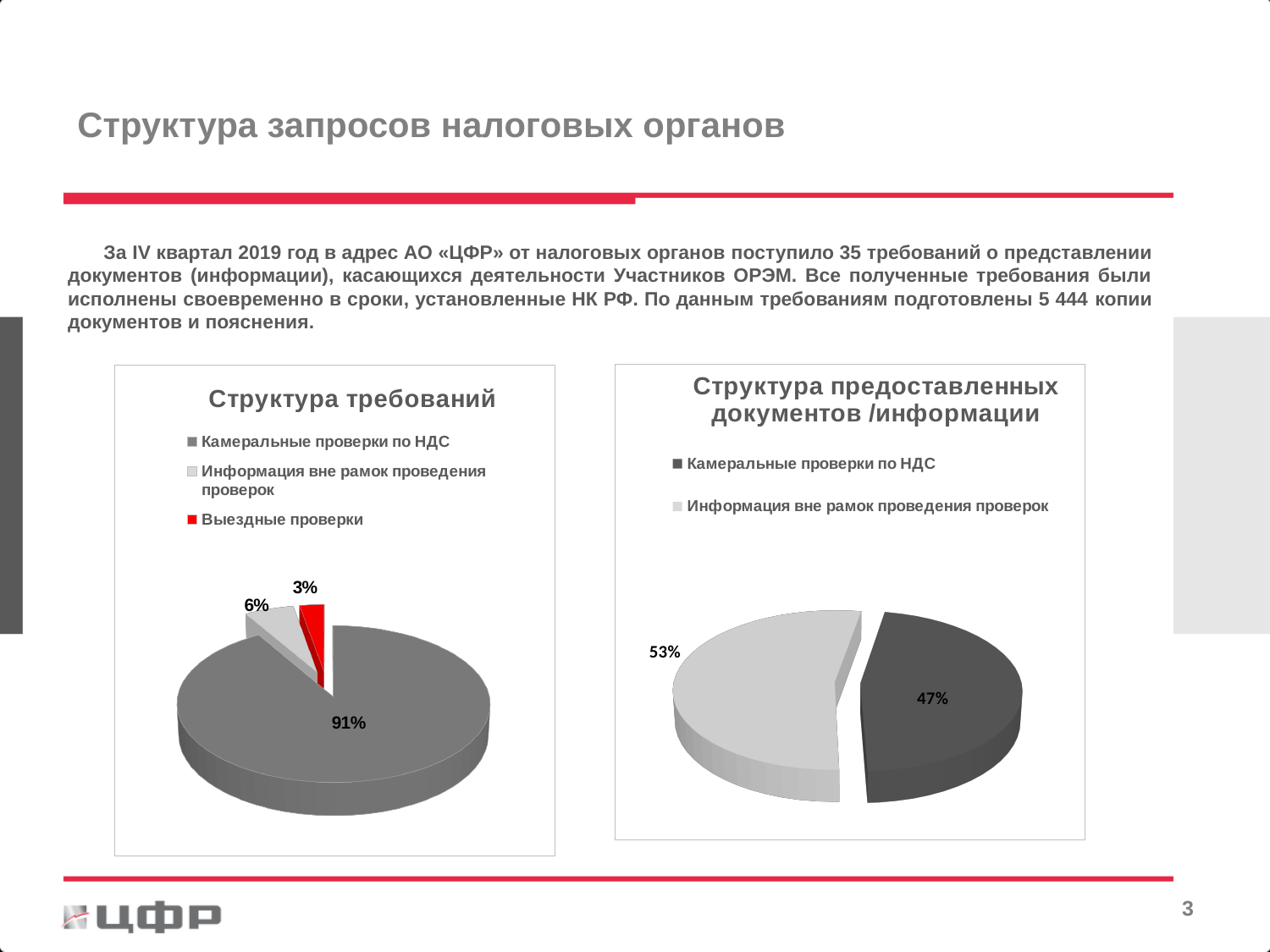
In the chart titled "Структура предоставленных документов /информации", what share does "Информация вне рамок проведения проверок" have? 53% In the chart titled "Структура требований", how many categories does the legend list? 3 In the chart titled "Структура требований", what share does "Выездные проверки" have? 3% In the chart titled "Структура требований", what colour is the "Выездные проверки" slice? Red In the chart titled "Структура требований", which category has the largest slice? Камеральные проверки по НДС In the chart titled "Структура требований", what share does "Информация вне рамок проведения проверок" have? 6% In the chart titled "Структура предоставленных документов /информации", which category has the larger slice? Информация вне рамок проведения проверок In the chart titled "Структура требований", which category has the smallest slice? Выездные проверки What type of chart is the chart titled "Структура предоставленных документов /информации"? Pie chart In the chart titled "Структура требований", what is the difference in percentage points between "Информация вне рамок проведения проверок" and "Выездные проверки"? 3